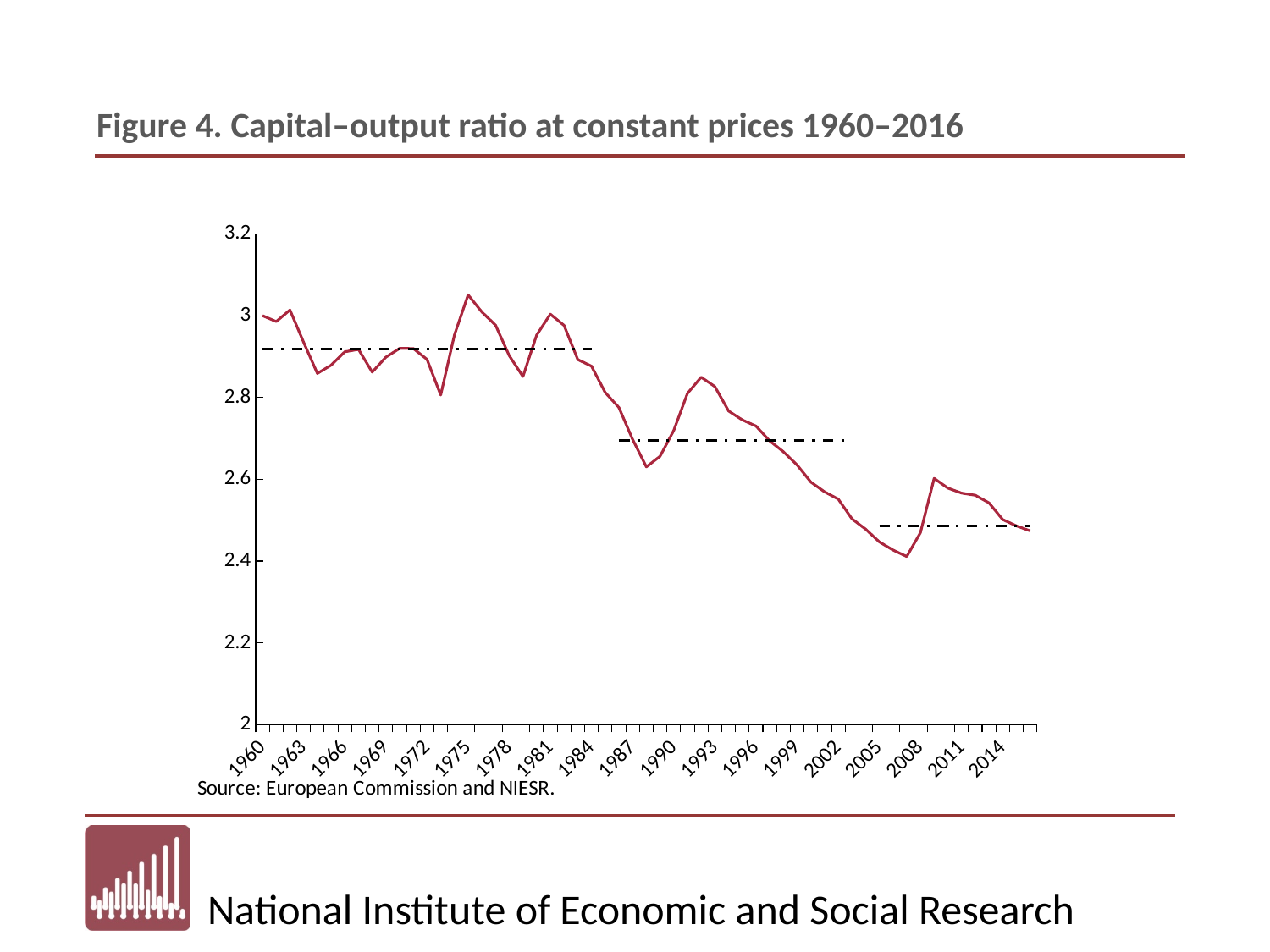
What is the title of the chart? Figure 4. Capital–output ratio at constant prices 1960–2016 Which is larger, the capital–output ratio in 1960 or in 2016? 1960 Is the capital–output ratio in 1993 greater or less than 2.8? greater Is the capital–output ratio in 2016 greater or less than 2.6? less Does the capital–output ratio generally rise or fall from 1960 to 2016? fall What source is cited below the chart? European Commission and NIESR Which is larger, the capital–output ratio in 1988 or in 1993? 1993 What type of chart is shown on the slide? line chart Is the capital–output ratio in 2007 greater or less than 2.6? less Which year has the lowest capital–output ratio on the chart? 2007